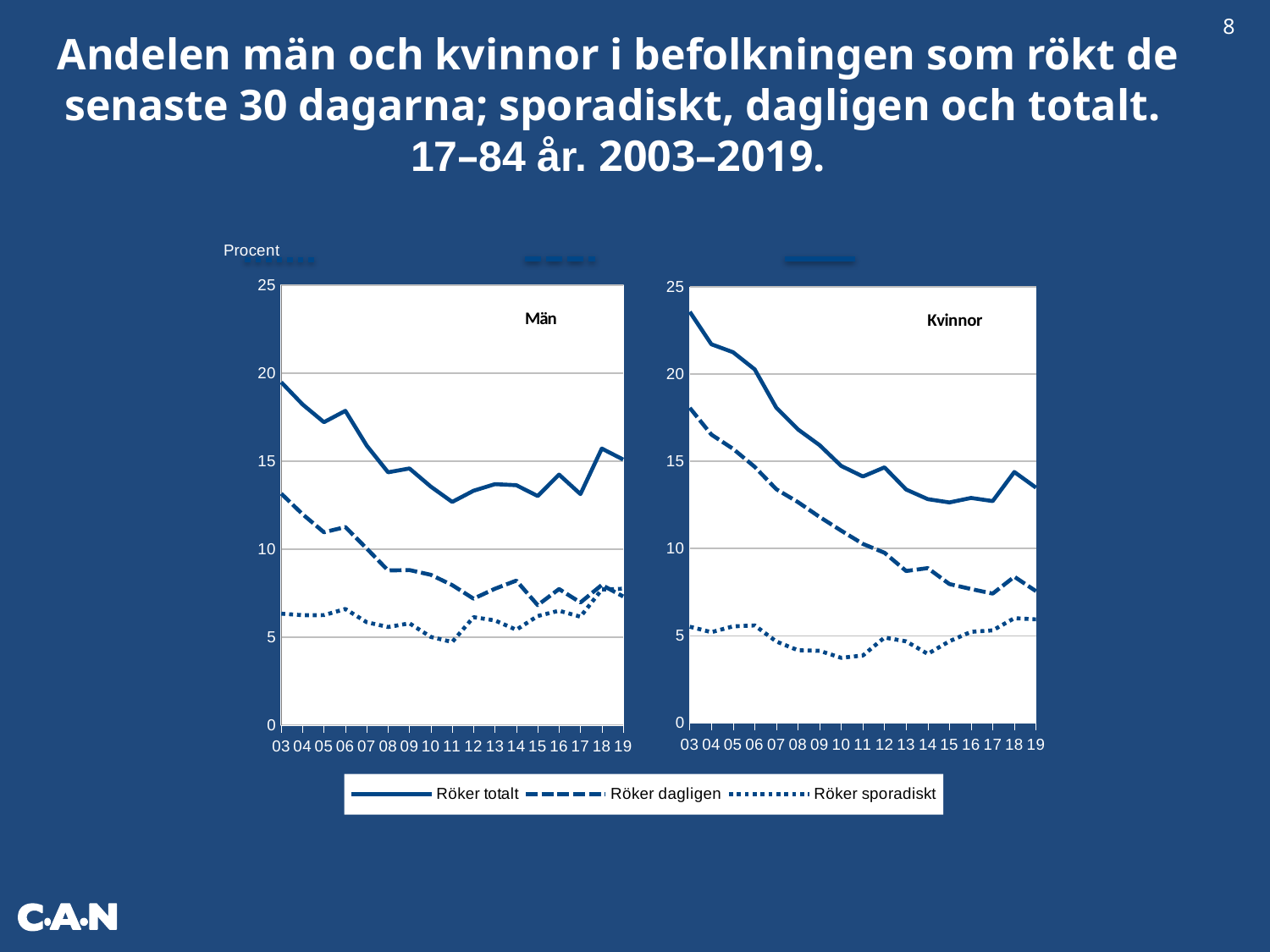
In the "Män" chart, is the value for Röker totalt in 03 greater or less than 15? greater In the "Män" chart, in which year is Röker totalt highest? 03 In the "Kvinnor" chart, is the value for Röker dagligen in 19 greater or less than 10? less In the "Kvinnor" chart, does the Röker totalt series generally rise or fall from 03 to 19? fall How many years are plotted along the x axis of the "Kvinnor" chart? 17 In the "Män" chart, which series has the higher value in 03, Röker dagligen or Röker sporadiskt? Röker dagligen How many series does the legend list for the charts? 3 In the "Män" chart, is the value for Röker dagligen in 03 greater or less than 10? greater What type of chart is the "Män" chart? line chart Which chart shows the higher value for Röker totalt in 03, "Män" or "Kvinnor"? Kvinnor